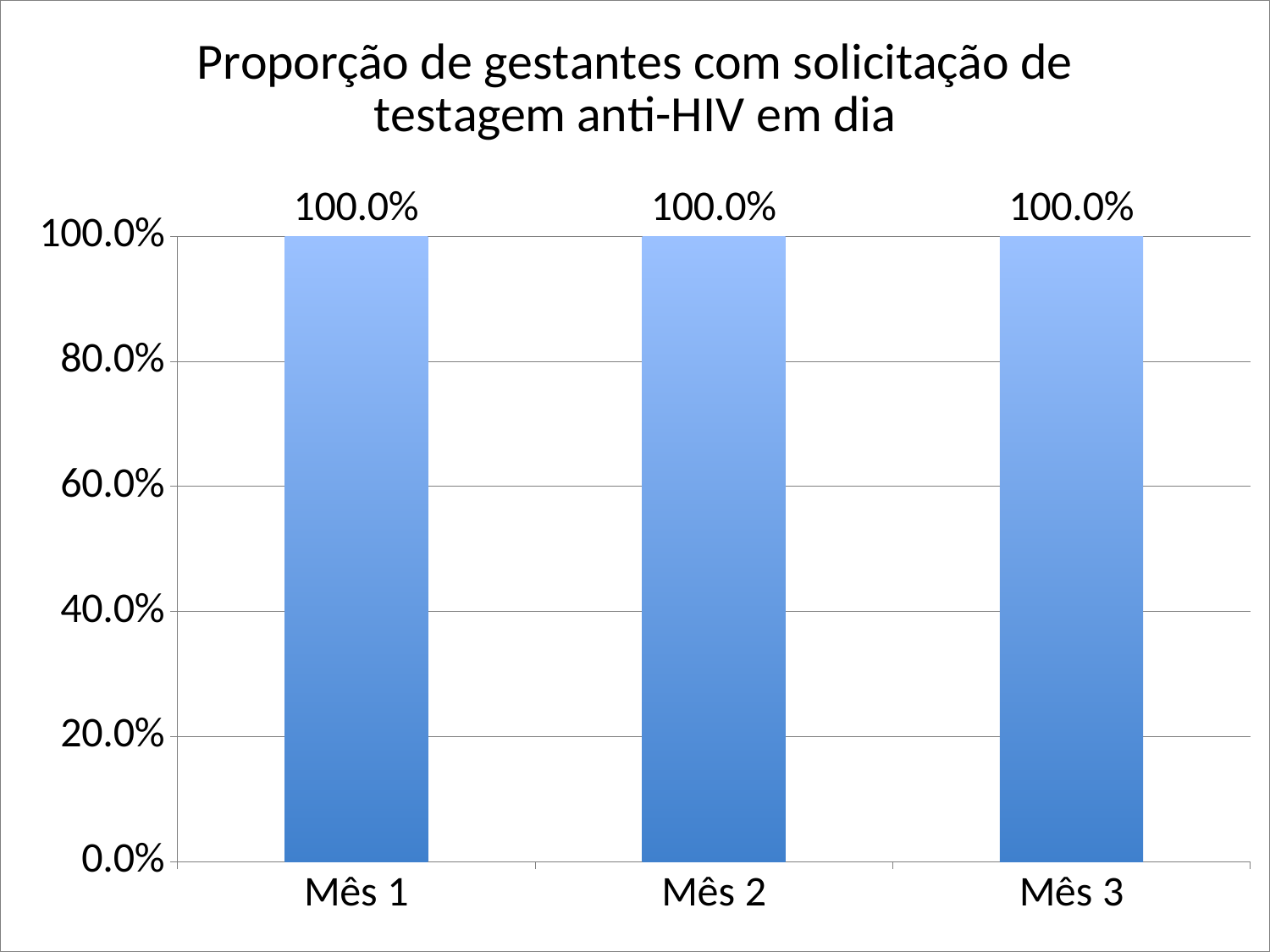
What is the value for Mês 2? 100.0% What is the value for Mês 1? 100.0% How many categories are shown on the x axis? 3 What kind of chart is shown on the slide? bar chart What is the highest value shown on the y axis? 100.0% What is the value for Mês 3? 100.0% What is the difference between the values for Mês 1 and Mês 3? 0.0% What is the title of the chart? Proporção de gestantes com solicitação de testagem anti-HIV em dia Do the values rise, fall or stay the same from Mês 1 to Mês 3? stay the same Is the value for Mês 2 greater or less than 80.0%? greater